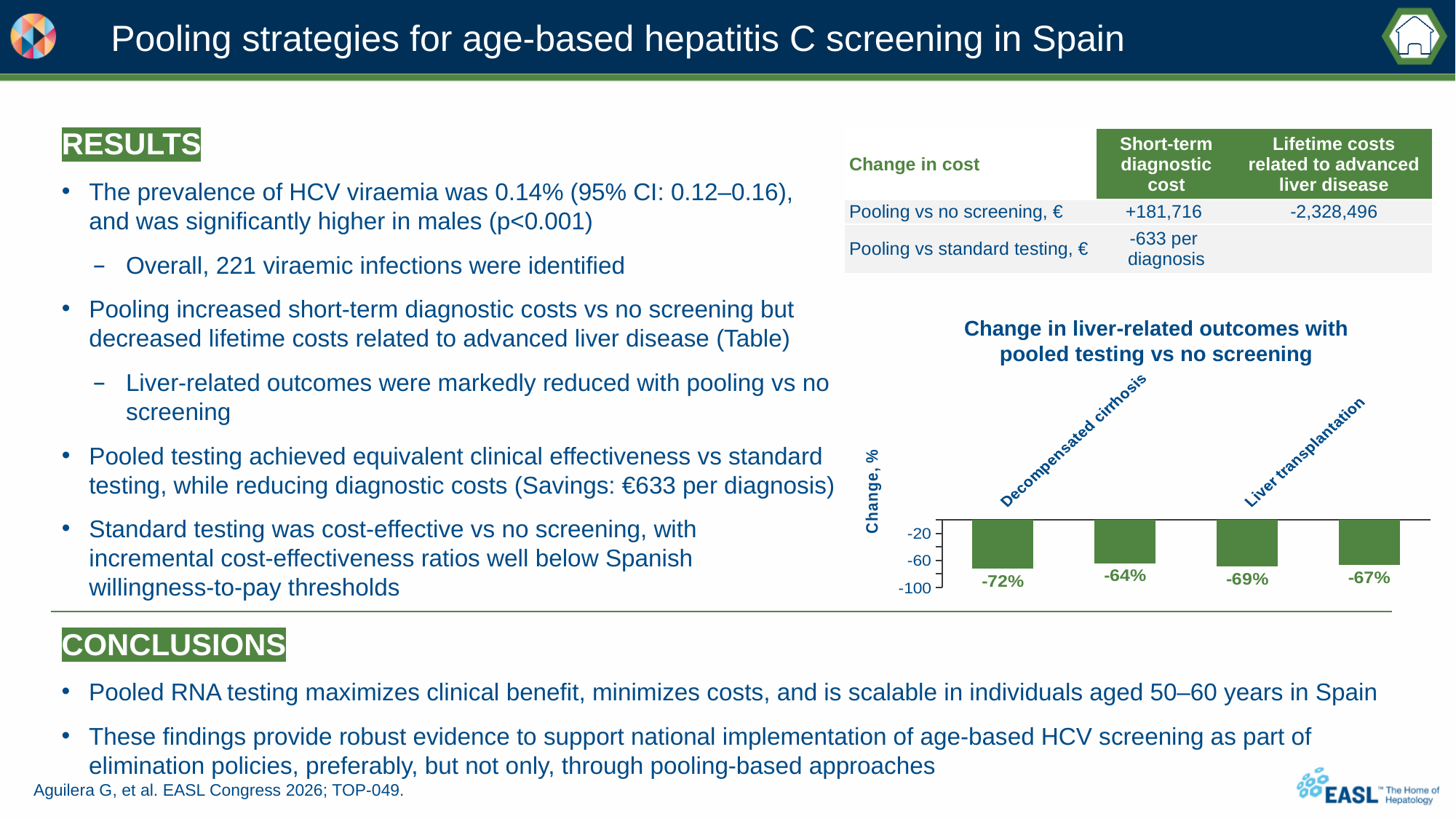
What type of chart is shown under the title 'Change in liver-related outcomes with pooled testing vs no screening'? Bar chart What is the y-axis label of the chart 'Change in liver-related outcomes with pooled testing vs no screening'? Change, % In the chart 'Change in liver-related outcomes with pooled testing vs no screening', what is the difference in percentage points between the change for decompensated cirrhosis and the change for liver transplantation? 3 percentage points How many bars are plotted in the chart 'Change in liver-related outcomes with pooled testing vs no screening'? 4 In the chart 'Change in liver-related outcomes with pooled testing vs no screening', which shows a larger reduction: decompensated cirrhosis or liver transplantation? Decompensated cirrhosis What colour are the bars in the chart 'Change in liver-related outcomes with pooled testing vs no screening'? Green In the chart 'Change in liver-related outcomes with pooled testing vs no screening', are all the plotted values negative or positive? Negative In the chart 'Change in liver-related outcomes with pooled testing vs no screening', what is the change for decompensated cirrhosis? -72% In the chart 'Change in liver-related outcomes with pooled testing vs no screening', what is the change for liver transplantation? -69% In the chart 'Change in liver-related outcomes with pooled testing vs no screening', is the value for decompensated cirrhosis greater or less than -60? less In the chart 'Change in liver-related outcomes with pooled testing vs no screening', which outcome has the lowest (most negative) value? Decompensated cirrhosis In the chart 'Change in liver-related outcomes with pooled testing vs no screening', is the value for liver transplantation greater or less than -100? greater